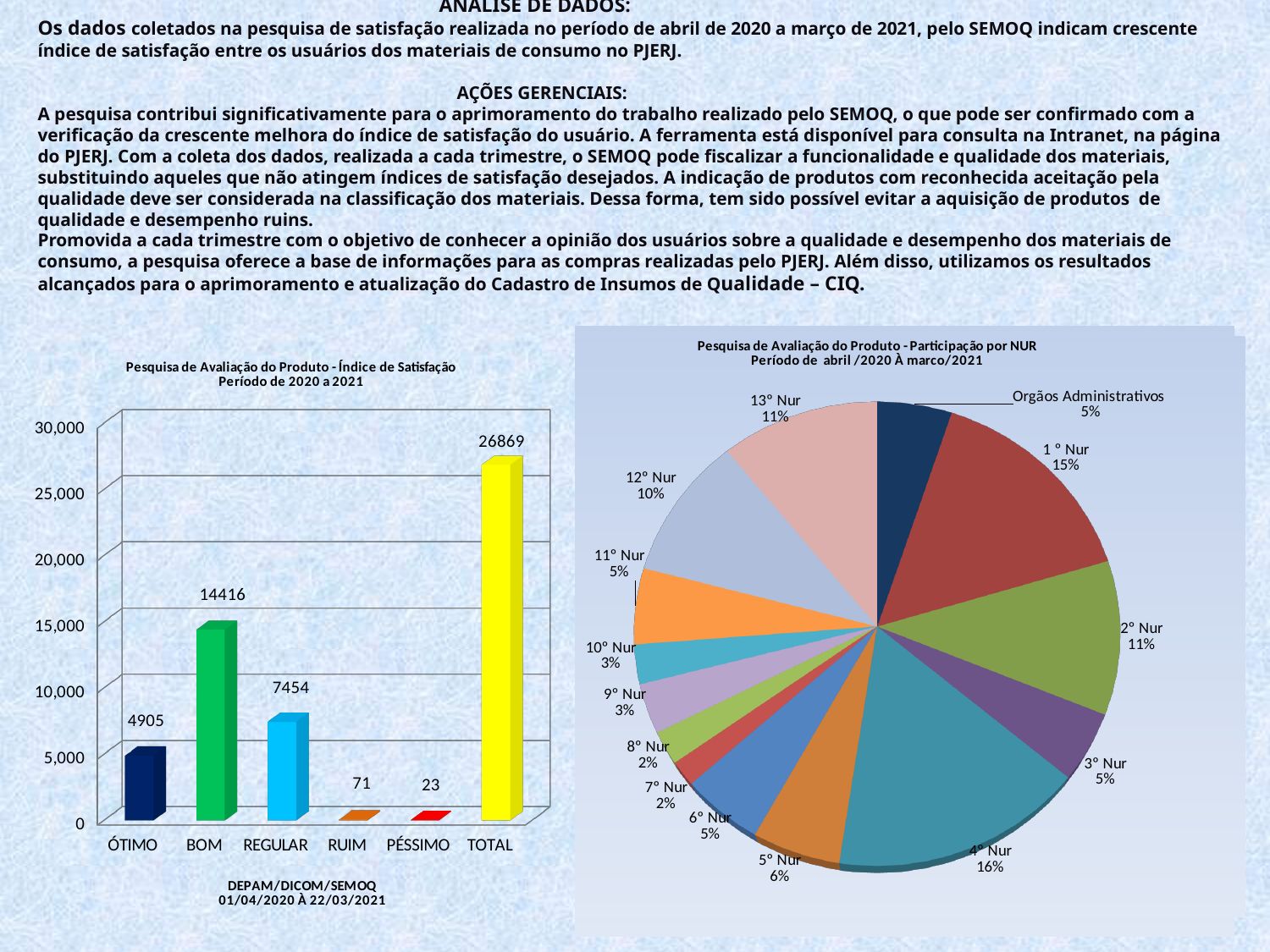
In the bar chart on the left, what is the value for PÉSSIMO? 23 In the bar chart on the left, what is the value for REGULAR? 7454 In the bar chart on the left, what is the value for BOM? 14416 In the pie chart on the right, how many slices are there? 14 What kind of chart is the chart on the left? Bar chart In the bar chart on the left, excluding TOTAL, which category has the highest value? BOM In the pie chart on the right, what share does 4° Nur have? 16% In the bar chart on the left, how many categories are shown on the x axis? 6 In the pie chart on the right, which slice has the largest share? 4° Nur In the bar chart on the left, what is the difference between the values for BOM and REGULAR? 6962 In the bar chart on the left, which is larger, the value for ÓTIMO or the value for REGULAR? REGULAR In the bar chart on the left, which category has the lowest value? PÉSSIMO